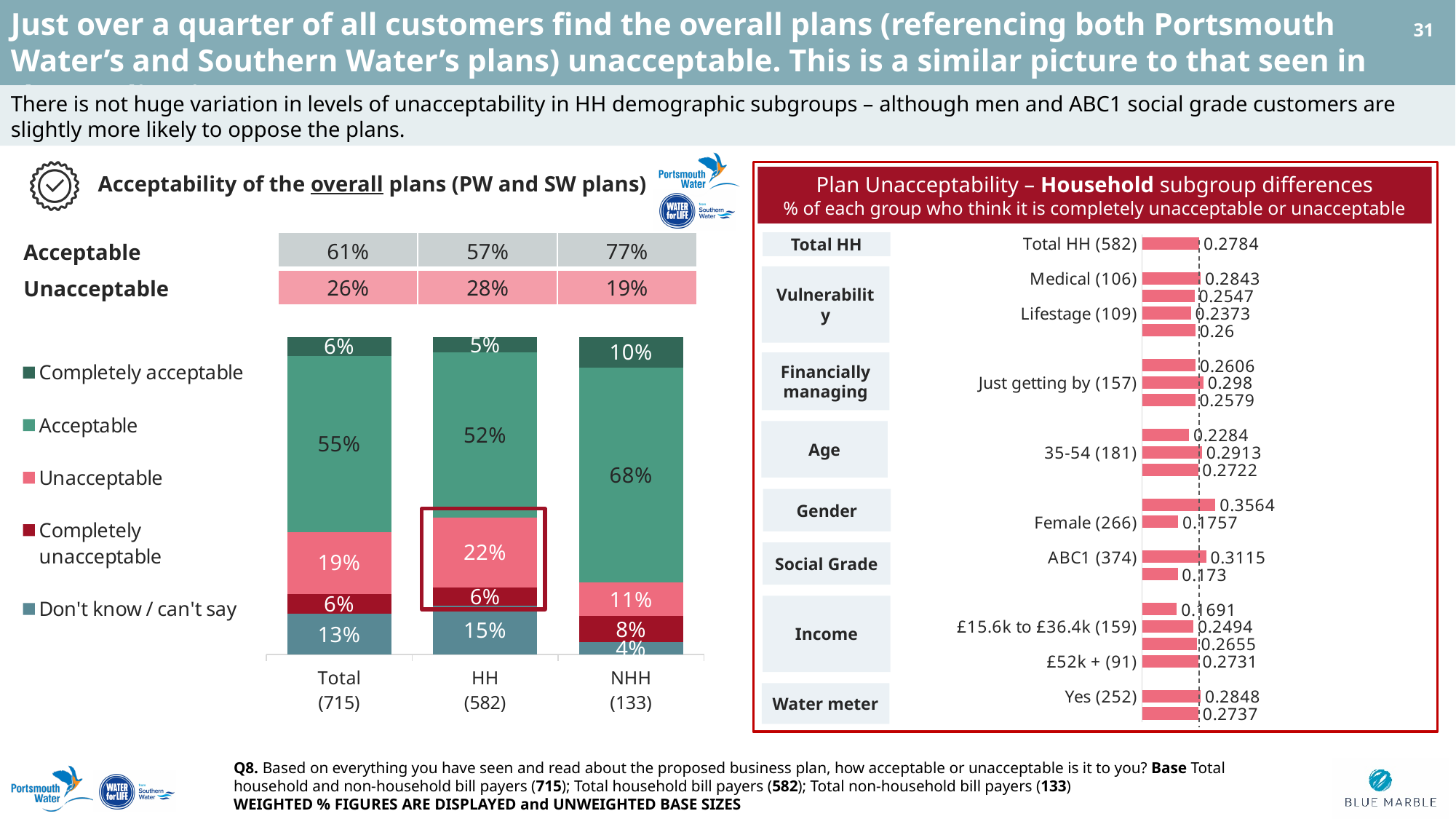
In the summary row above the 'Acceptability of the overall plans' chart, what is the total 'Acceptable' figure for NHH? 77% In the 'Acceptability of the overall plans' chart, what is the 'Unacceptable' value for HH (582)? 22% In the 'Acceptability of the overall plans' chart, what is the 'Acceptable' value for NHH (133)? 68% In the 'Acceptability of the overall plans' chart, which group has the highest 'Acceptable' segment? NHH (133) In the 'Acceptability of the overall plans' chart, how many groups are shown on the x axis? 3 What kind of chart is the 'Acceptability of the overall plans (PW and SW plans)' chart? Stacked bar chart How many series does the legend of the 'Acceptability of the overall plans' chart list? 5 In the 'Acceptability of the overall plans' chart, which has the larger 'Don't know / can't say' value, Total or HH? HH In the 'Plan Unacceptability – Household subgroup differences' chart, what is the value for ABC1 (374)? 0.3115 In the 'Plan Unacceptability – Household subgroup differences' chart, which is larger, the value for Just getting by (157) or for Total HH (582)? Just getting by (157) In the 'Plan Unacceptability – Household subgroup differences' chart, what is the value for Female (266)? 0.1757 In the 'Acceptability of the overall plans' chart, what is the difference between the 'Unacceptable' values for HH and Total? 3 percentage points